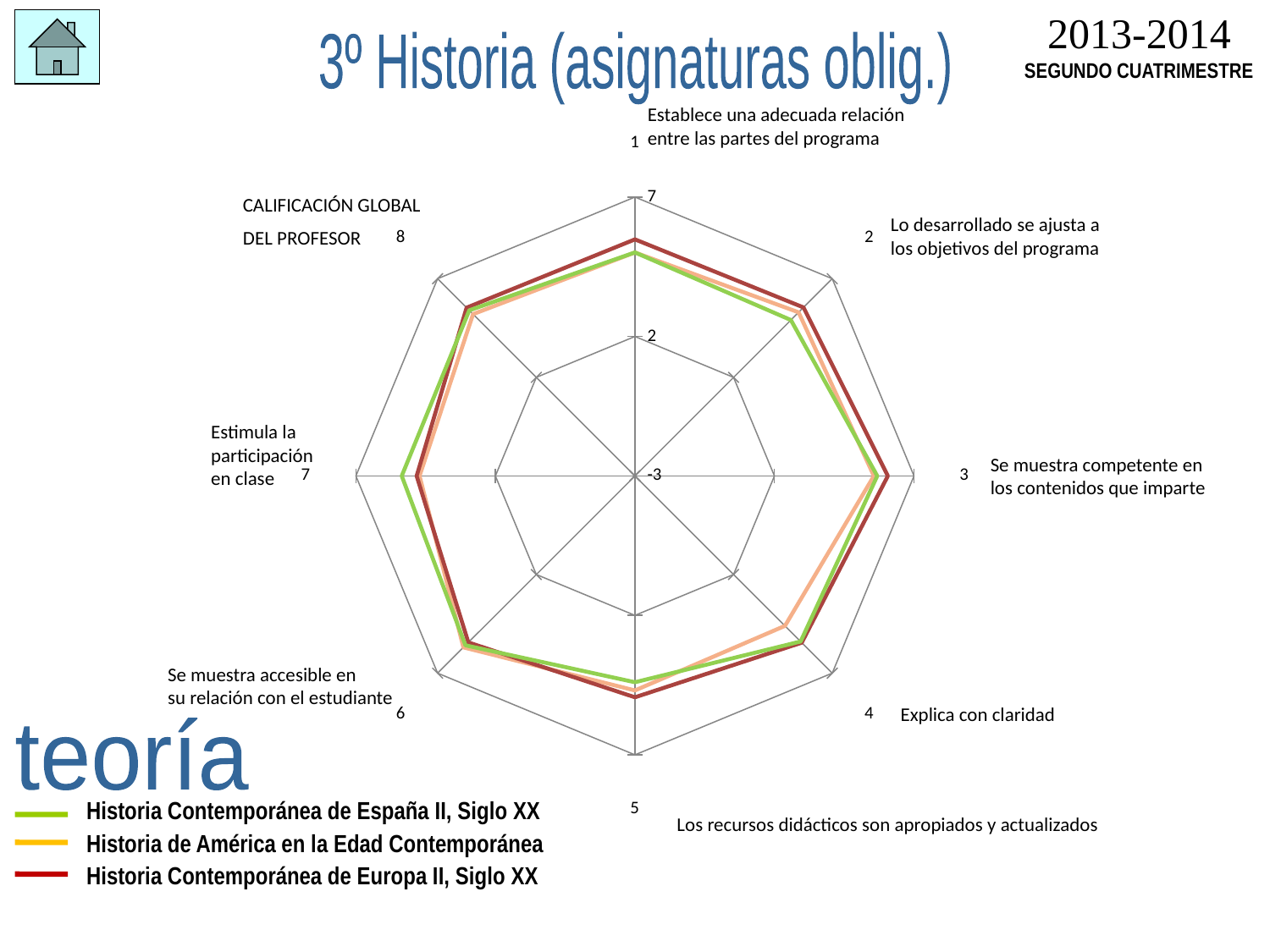
For 'Lo desarrollado se ajusta a los objetivos del programa', which series has the higher value: Historia Contemporánea de España II, Siglo XX or Historia Contemporánea de Europa II, Siglo XX? Historia Contemporánea de Europa II, Siglo XX How many series does the legend list? 3 For 'Explica con claridad', which series has the lower value: Historia de América en la Edad Contemporánea or Historia Contemporánea de Europa II, Siglo XX? Historia de América en la Edad Contemporánea What is the title of the chart on the slide? 3º Historia (asignaturas oblig.) Is the value for 'Estimula la participación en clase' for Historia de América en la Edad Contemporánea greater or less than 2? greater What kind of chart is shown on the slide? Radar chart Is the value for 'Explica con claridad' for Historia Contemporánea de Europa II, Siglo XX greater or less than 2? greater Is the value for 'Se muestra competente en los contenidos que imparte' for Historia Contemporánea de España II, Siglo XX greater or less than 7? less Which subject is shown by the red line in the legend? Historia Contemporánea de Europa II, Siglo XX Which category label is numbered 5 on the radar chart? Los recursos didácticos son apropiados y actualizados How many evaluation categories (axes) does the radar chart have? 8